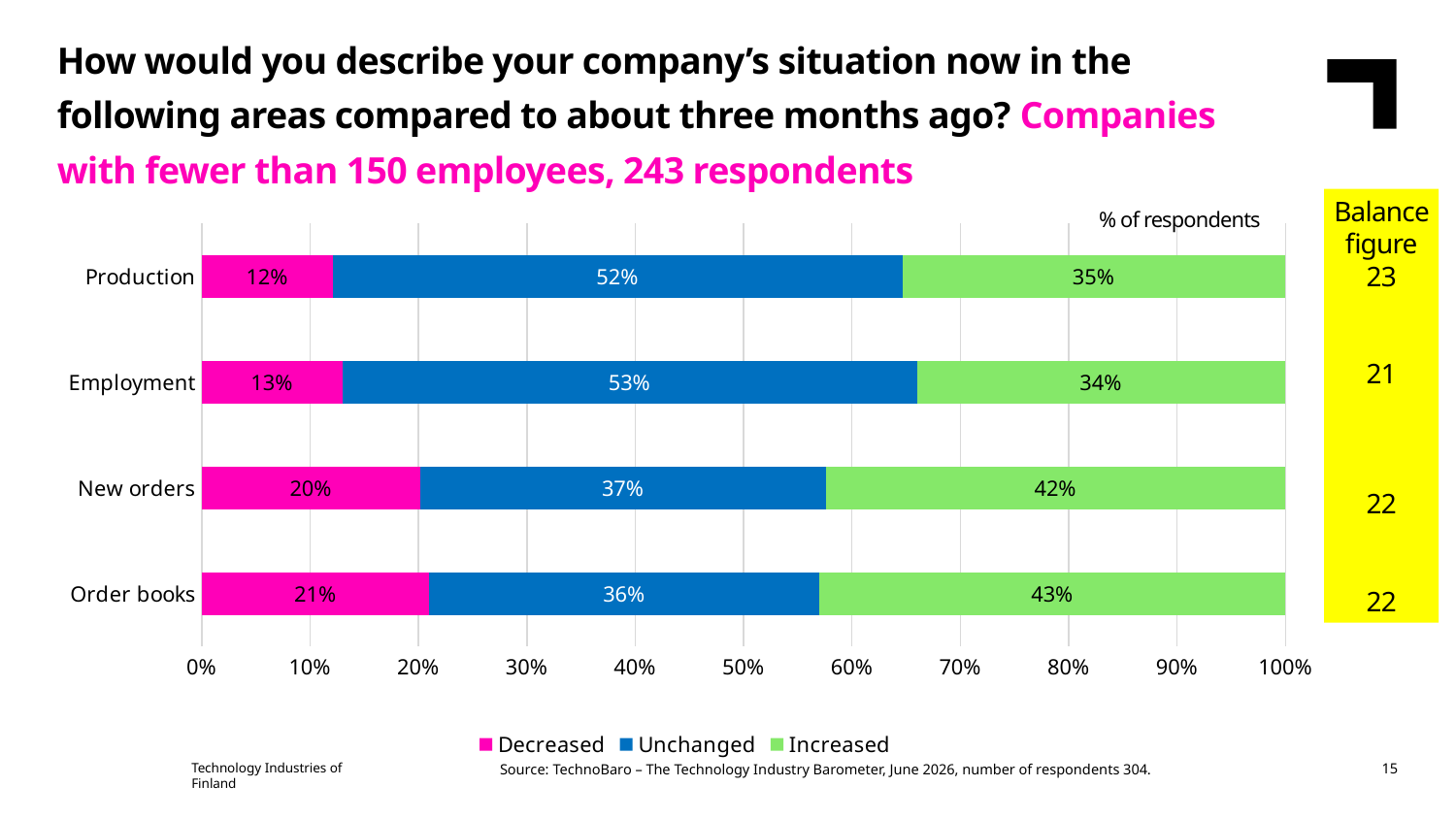
What percentage of respondents reported that Production was Unchanged? 52% What percentage of respondents reported that New orders Decreased? 20% Which category has the lowest share of respondents reporting Decreased? Production What is the total of the Decreased and Unchanged shares for Production? 64% What is the difference between the Unchanged share for Employment and the Unchanged share for Order books? 17 percentage points How many series does the legend list? 3 Which colour represents the Decreased series in the legend? Pink (magenta) Which is larger: the Increased share for New orders or the Increased share for Employment? New orders What kind of chart is shown on the slide? Stacked bar chart What percentage of respondents reported that Order books Increased? 43% How many categories are shown on the chart? 4 Which category has the highest share of respondents reporting Increased? Order books